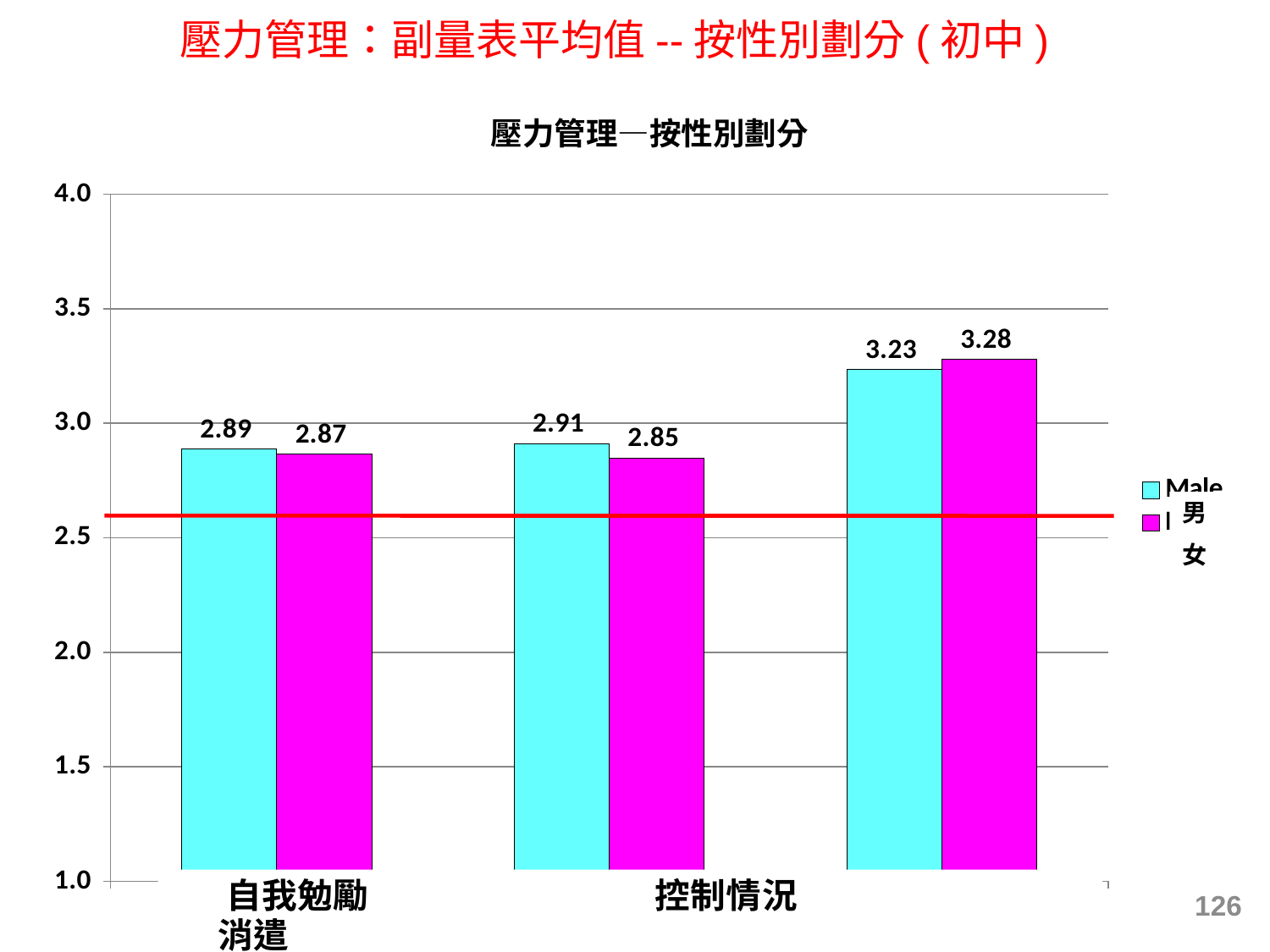
What is the value for 男 (Male) in the 控制情況 category? 2.91 What kind of chart is shown on the slide? bar chart In the 控制情況 category, which is larger, the 男 value or the 女 value? 男 What is the value for 男 (Male) in the 自我勉勵 category? 2.89 What is the value for 女 in the 自我勉勵 category? 2.87 What is the title of the chart? 壓力管理─按性別劃分 What is the value for 女 in the 控制情況 category? 2.85 How many series does the legend list? 2 Is the value for 男 in the 控制情況 category greater or less than 2.5? greater What is the highest value labelled on the chart? 3.28 What is the difference between the 男 and 女 values in the 自我勉勵 category? 0.02 What is the difference between the 男 and 女 values in the 控制情況 category? 0.06